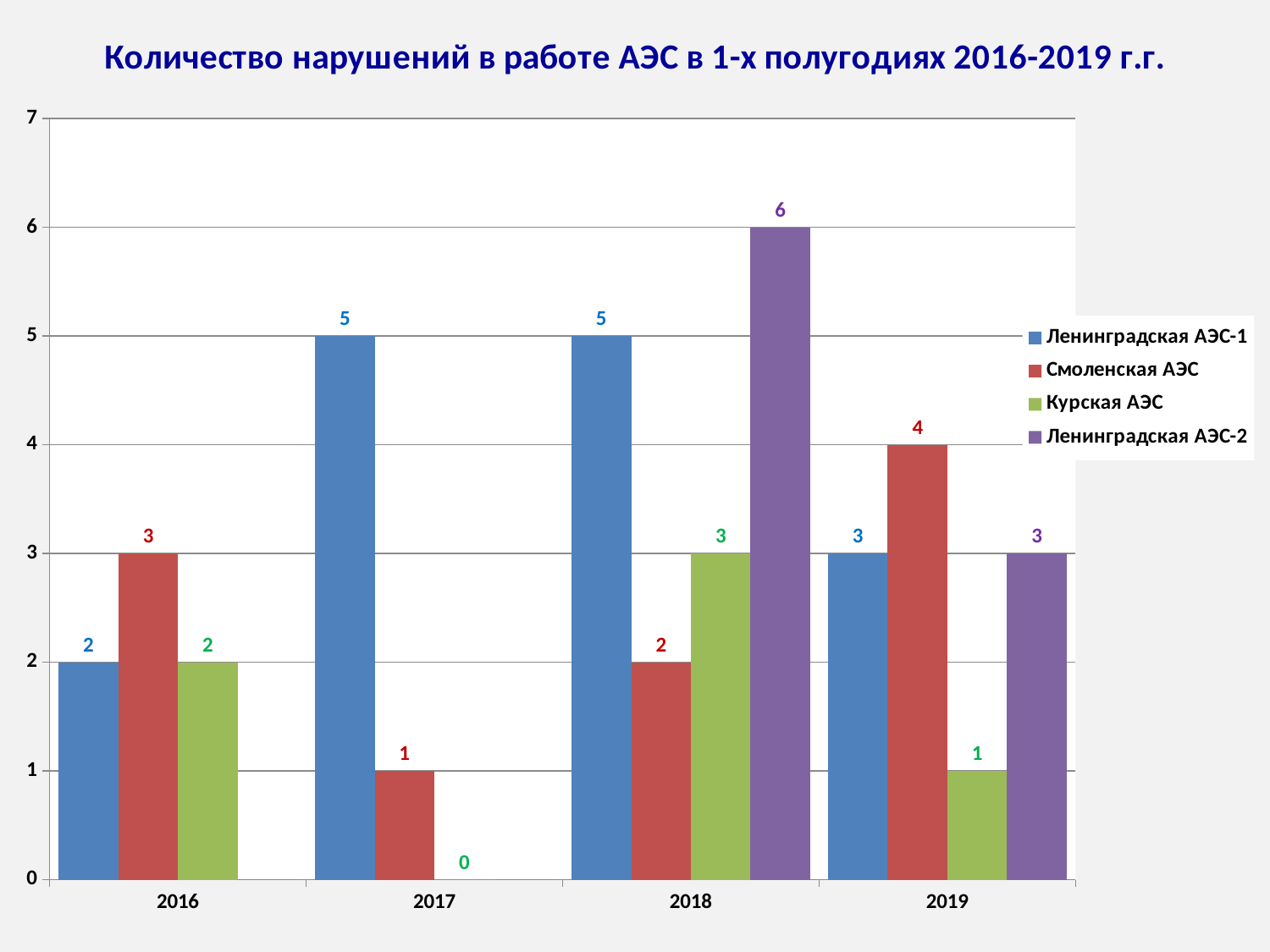
What is the value for Ленинградская АЭС-1 in 2017? 5 What is the difference between Ленинградская АЭС-2 and Смоленская АЭС in 2018? 4 How many series does the legend list? 4 What is the value for Смоленская АЭС in 2019? 4 What kind of chart is shown on the slide? Bar chart Which is larger in 2016: Смоленская АЭС or Курская АЭС? Смоленская АЭС What is the title of the chart? Количество нарушений в работе АЭС в 1-х полугодиях 2016-2019 г.г. Which series has the highest value in 2018? Ленинградская АЭС-2 Which series has the lowest value in 2019? Курская АЭС What is the value for Курская АЭС in 2017? 0 How many years are shown on the x axis? 4 What is the value for Ленинградская АЭС-2 in 2018? 6